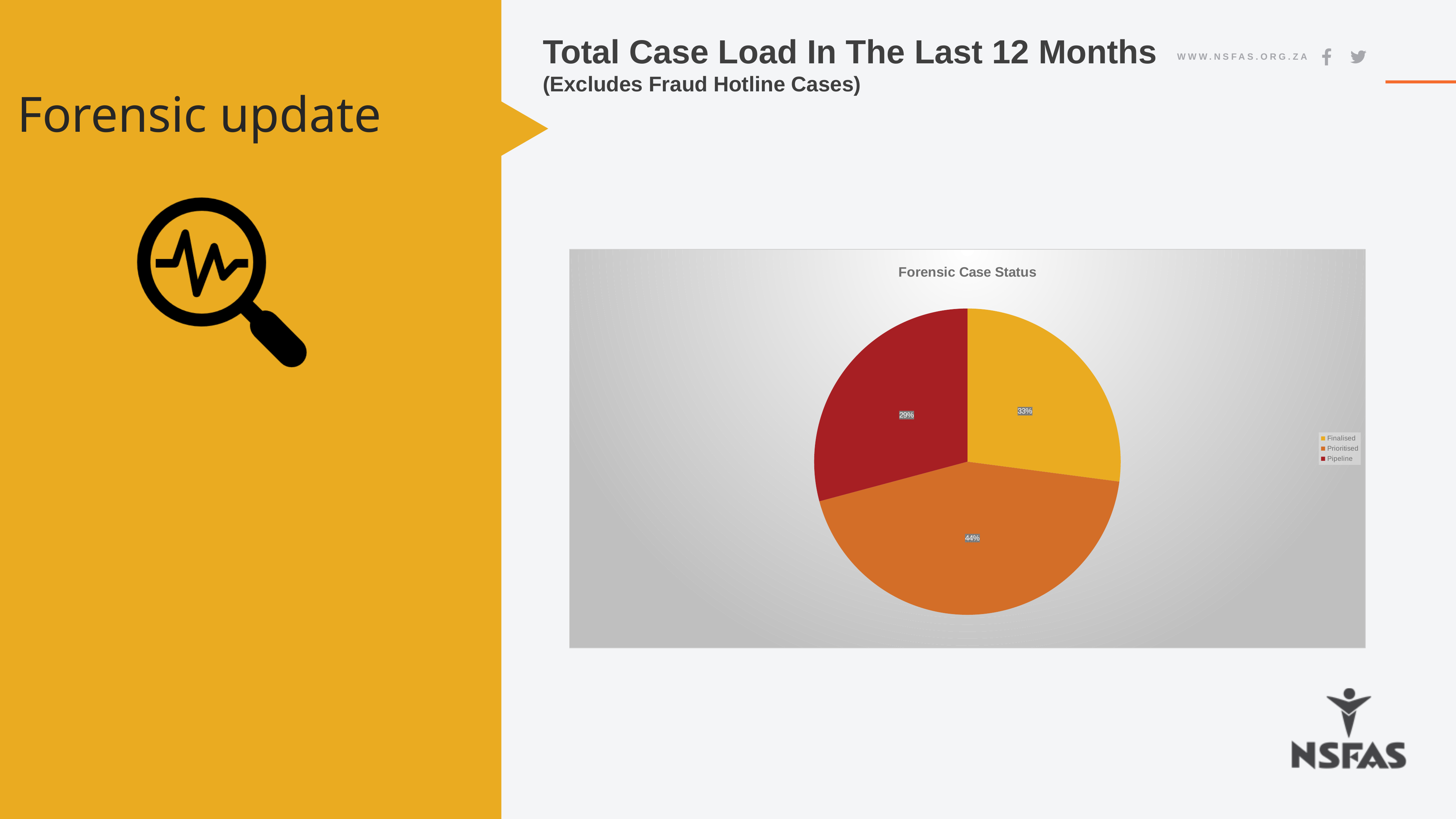
What kind of chart is shown on the slide? pie chart What share of the pie is Pipeline? 29% How many categories does the pie chart show? 3 What is the title of the chart? Forensic Case Status What is the difference in percentage points between the Prioritised and Finalised slices? 11 Which category has the largest slice of the pie? Prioritised What colour is the Pipeline slice? dark red What share of the pie is Finalised? 33% What share of the pie is Prioritised? 44%